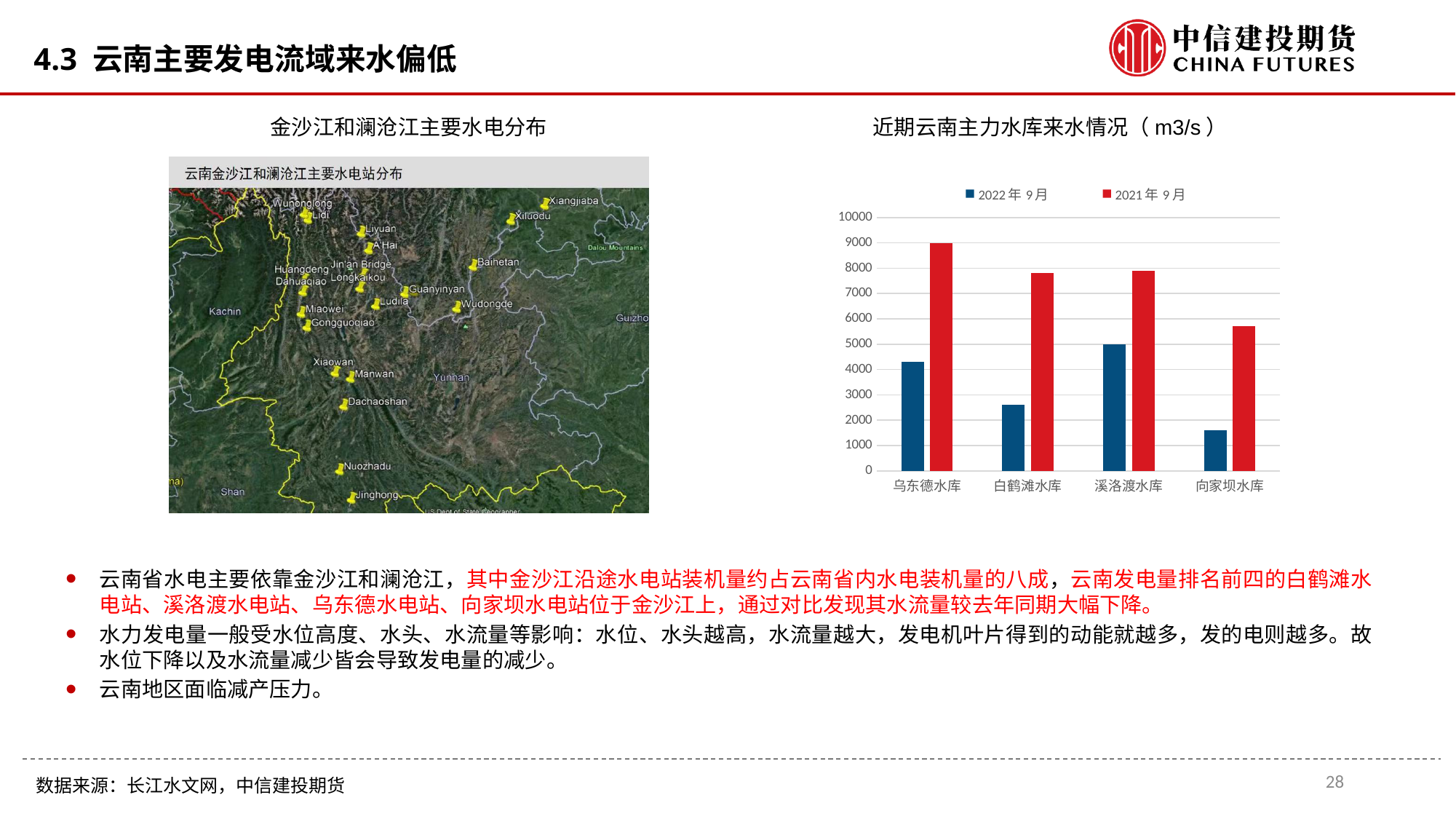
How many series does the legend of the 近期云南主力水库来水情况 chart list? 2 What kind of chart is the chart titled 近期云南主力水库来水情况（m3/s）? bar chart In the 近期云南主力水库来水情况 chart, is the 2021年9月 value for 乌东德水库 greater or less than 8000? greater In the 近期云南主力水库来水情况 chart, is the 2022年9月 value for 白鹤滩水库 greater or less than 3000? less In the 近期云南主力水库来水情况 chart, is the 2022年9月 value for 向家坝水库 greater or less than 2000? less In the 近期云南主力水库来水情况 chart, which is larger for 乌东德水库: the 2022年9月 value or the 2021年9月 value? 2021年9月 In the 近期云南主力水库来水情况 chart, which reservoir has the highest value for 2021年9月? 乌东德水库 How many reservoirs are shown on the x axis of the 近期云南主力水库来水情况 chart? 4 In the 近期云南主力水库来水情况 chart, which reservoir has the lowest value for 2021年9月? 向家坝水库 In the 近期云南主力水库来水情况 chart, which reservoir has the lowest value for 2022年9月? 向家坝水库 In the 近期云南主力水库来水情况 chart, which colour represents the 2021年9月 series? red In the 近期云南主力水库来水情况 chart, which reservoir has the highest value for 2022年9月? 溪洛渡水库